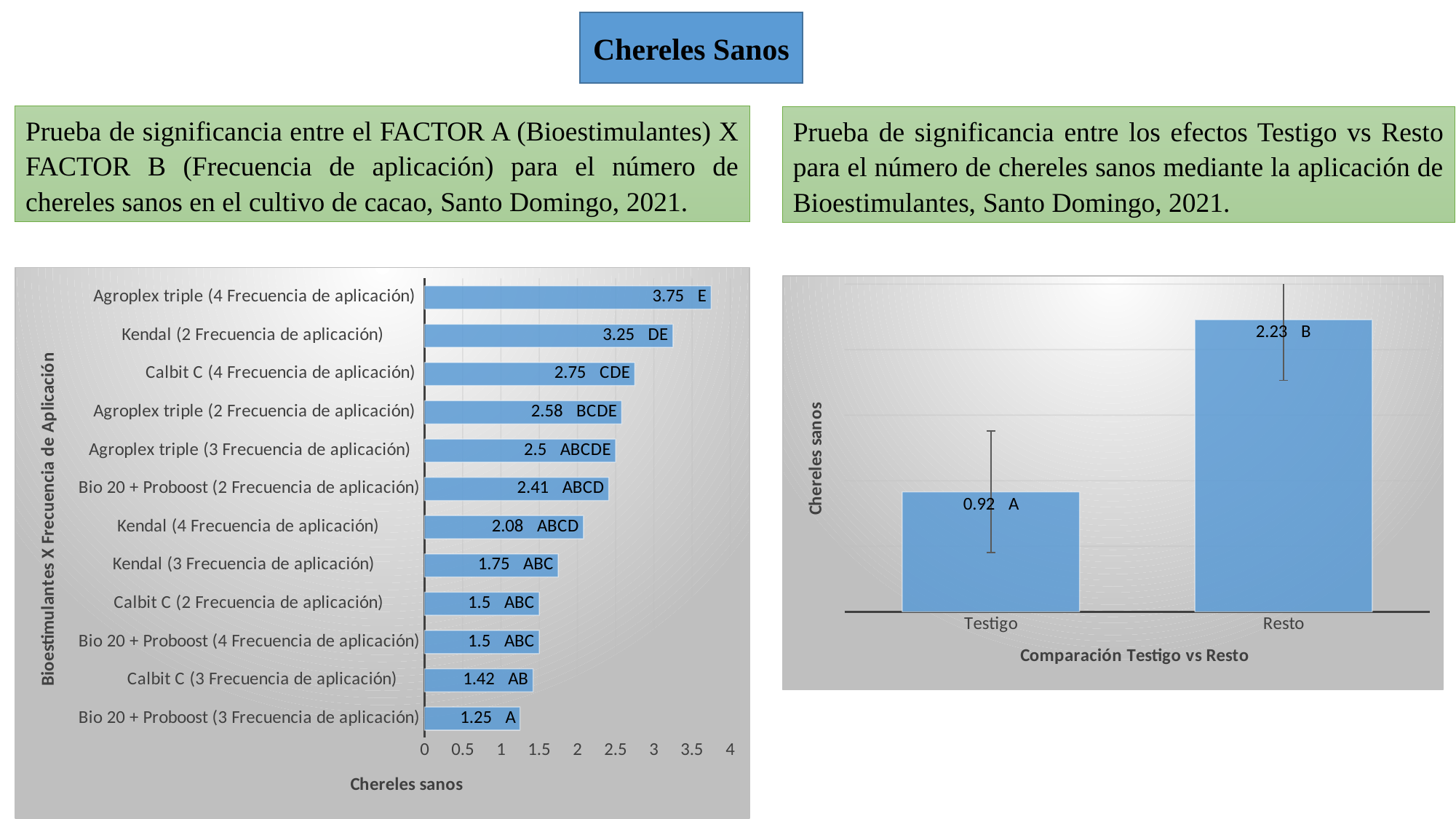
In the right chart, what is the value for Resto? 2.23 In the left chart, which is larger: Agroplex triple (2 Frecuencia de aplicación) or Kendal (4 Frecuencia de aplicación)? Agroplex triple (2 Frecuencia de aplicación) What is the x-axis title of the right chart? Comparación Testigo vs Resto In the left chart, what is the difference between Kendal (2 Frecuencia de aplicación) and Calbit C (4 Frecuencia de aplicación)? 0.5 In the left chart, which category has the lowest value? Bio 20 + Proboost (3 Frecuencia de aplicación) In the right chart, what is the difference between Resto and Testigo? 1.31 In the left chart, what is the value for Kendal (3 Frecuencia de aplicación)? 1.75 In the left chart, which category has the highest value? Agroplex triple (4 Frecuencia de aplicación) What kind of chart is the left chart? Bar chart How many categories are plotted in the left chart? 12 In the left chart, what is the value for Agroplex triple (4 Frecuencia de aplicación)? 3.75 In the right chart, what is the value for Testigo? 0.92